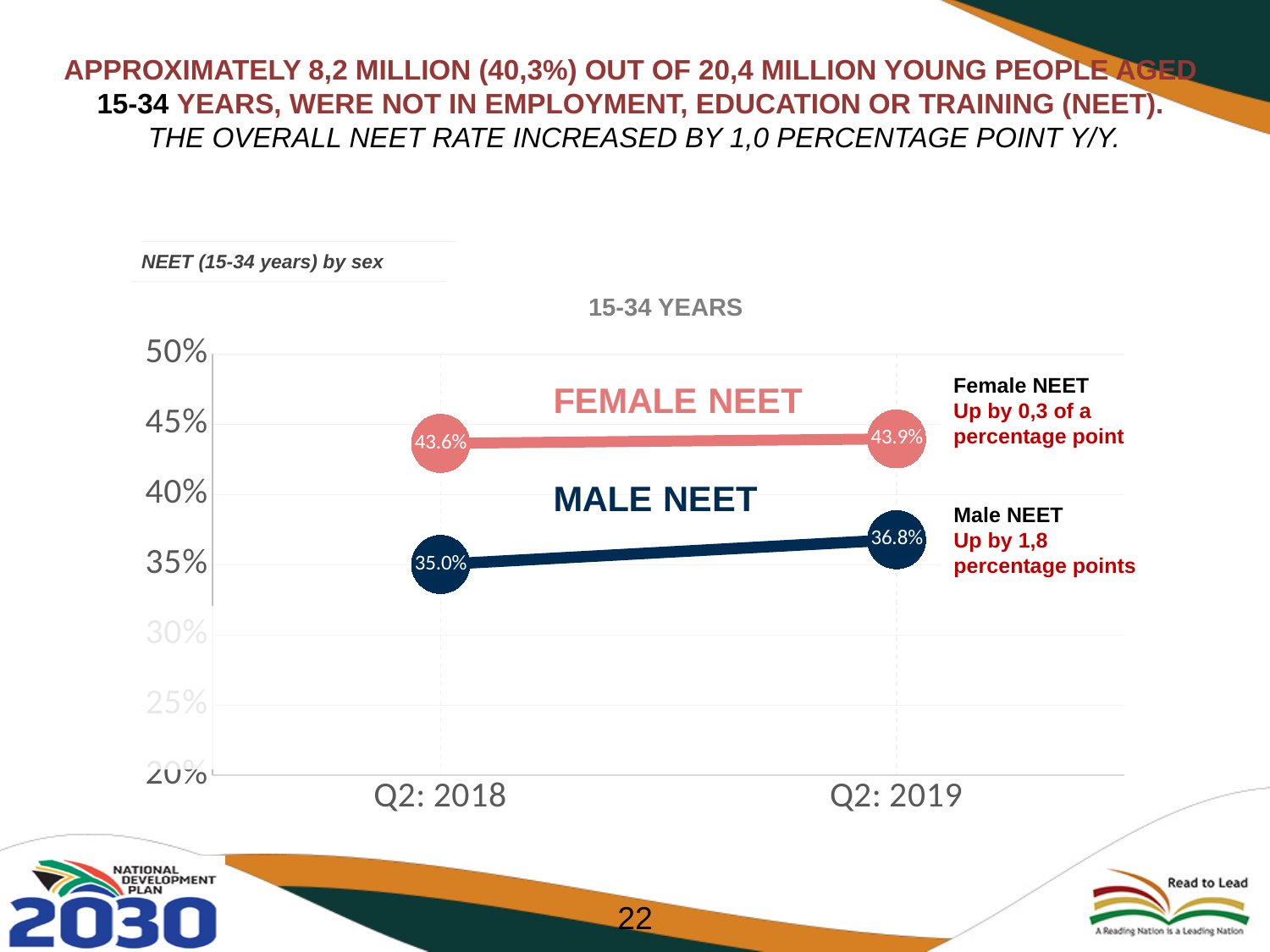
What is the Male NEET rate in Q2: 2019? 36.8% How many time periods are shown on the x axis? 2 What kind of chart is shown on the slide? line chart Which series has the higher value in Q2: 2019, Female NEET or Male NEET? Female NEET Does the Male NEET rate rise or fall from Q2: 2018 to Q2: 2019? rise What is the Male NEET rate in Q2: 2018? 35.0% What is the Female NEET rate in Q2: 2019? 43.9% Is the Male NEET value for Q2: 2018 greater or less than 40%? less What is the difference between the Female NEET and Male NEET rates in Q2: 2018? 8.6 percentage points What is the Female NEET rate in Q2: 2018? 43.6% By how many percentage points did the Male NEET rate change from Q2: 2018 to Q2: 2019? 1.8